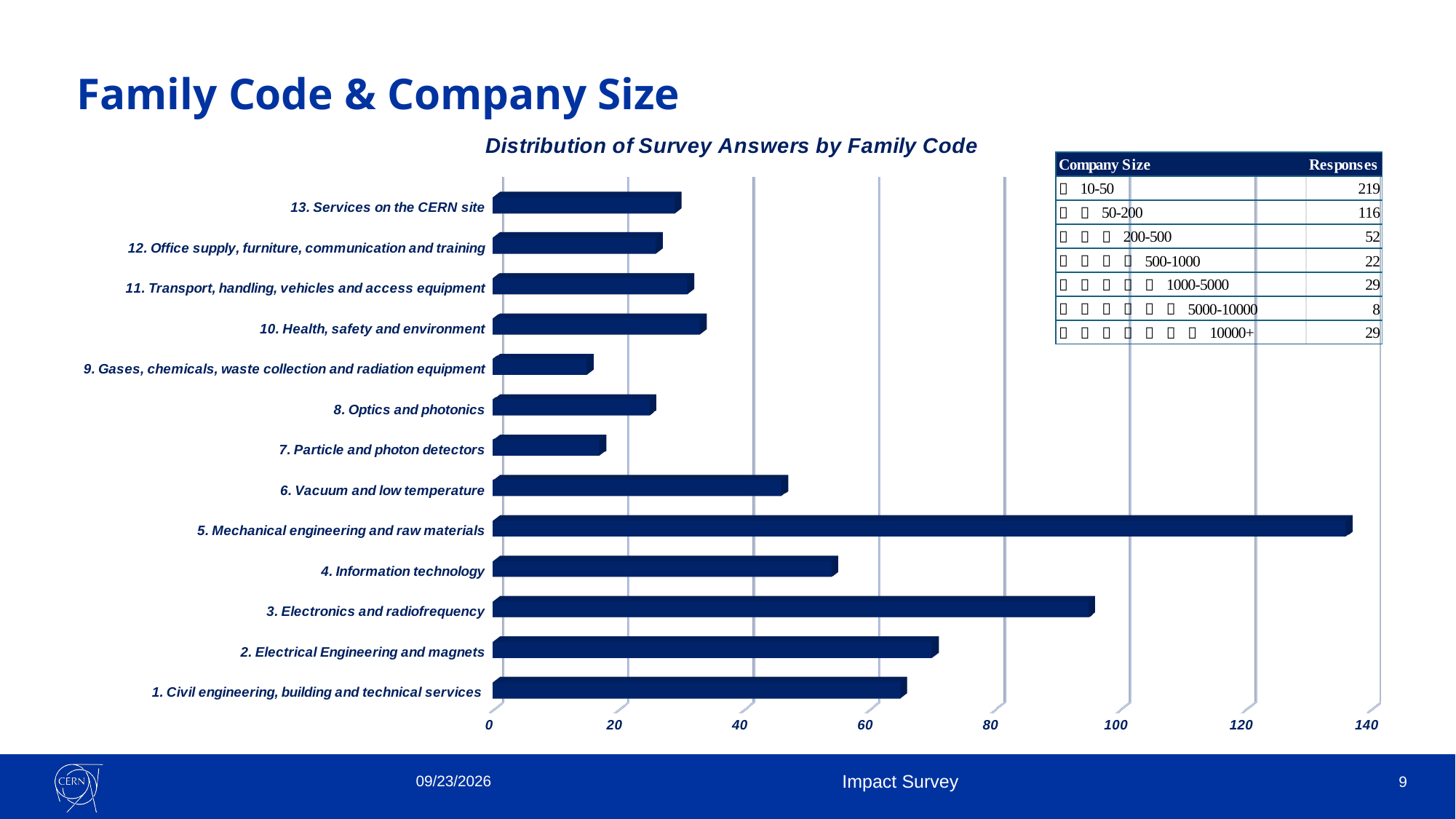
How many family code categories are plotted in the chart? 13 Which has more survey answers: 3. Electronics and radiofrequency or 2. Electrical Engineering and magnets? 3. Electronics and radiofrequency Is the value for 3. Electronics and radiofrequency greater or less than 80? greater Which has more survey answers: 4. Information technology or 6. Vacuum and low temperature? 4. Information technology What kind of chart is shown on the slide? bar chart Is the value for 6. Vacuum and low temperature greater or less than 40? greater Is the value for 9. Gases, chemicals, waste collection and radiation equipment greater or less than 20? less Which family code has the highest number of survey answers? 5. Mechanical engineering and raw materials What is the title of the chart? Distribution of Survey Answers by Family Code